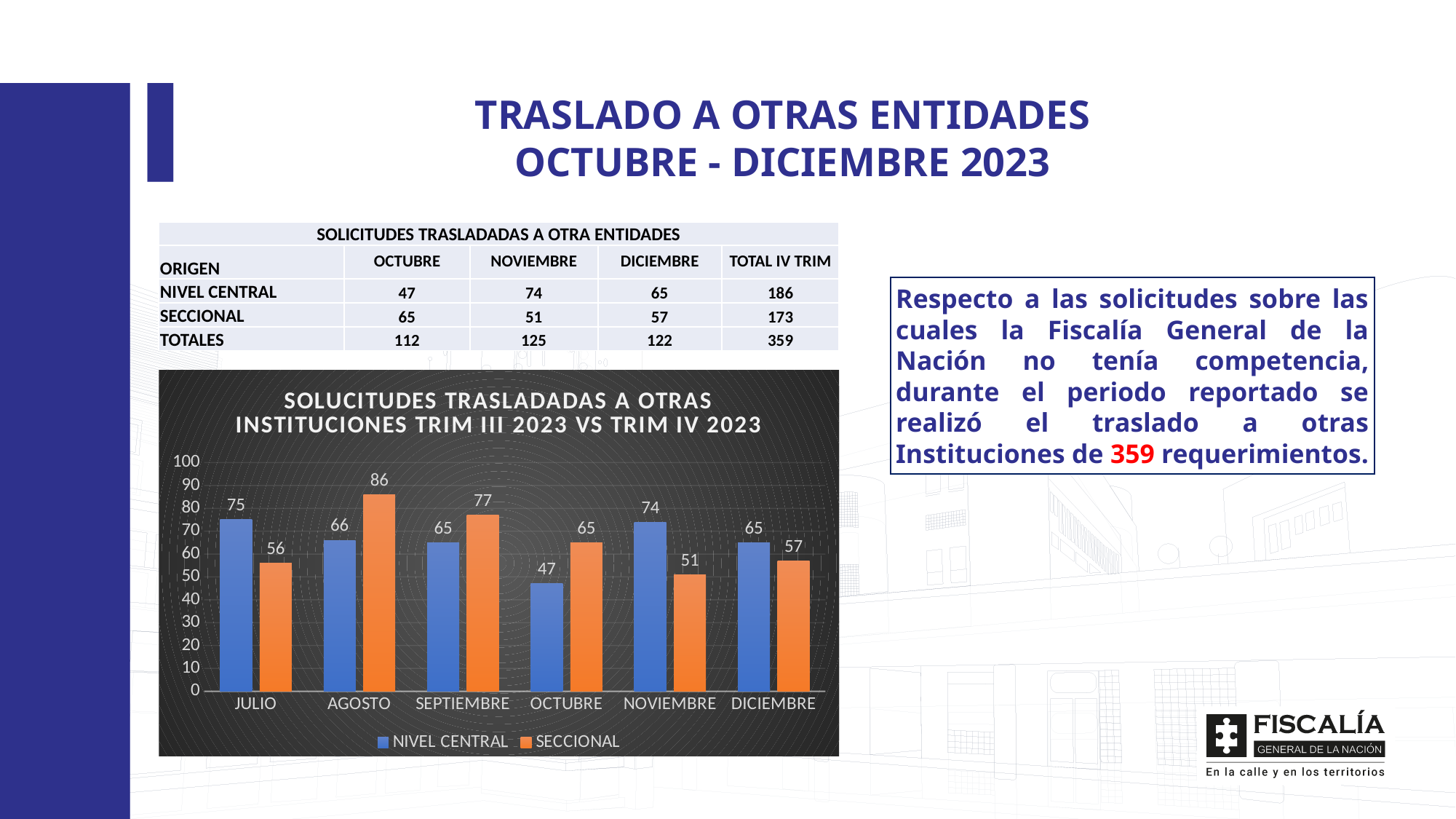
How many series does the chart legend list? 2 In SEPTIEMBRE, which series has the larger value, NIVEL CENTRAL or SECCIONAL? SECCIONAL What kind of chart is shown on the slide? Bar chart What is the difference between the NIVEL CENTRAL and SECCIONAL values for NOVIEMBRE? 23 How many months are shown on the x axis of the chart? 6 What is the NIVEL CENTRAL value for OCTUBRE in the chart? 47 What is the SECCIONAL value for AGOSTO in the chart? 86 Which month has the highest SECCIONAL value in the chart? AGOSTO What is the NIVEL CENTRAL value for JULIO in the chart? 75 Which month has the lowest NIVEL CENTRAL value in the chart? OCTUBRE What colour are the SECCIONAL bars in the chart? Orange Is the SECCIONAL value for OCTUBRE greater or less than 60? greater